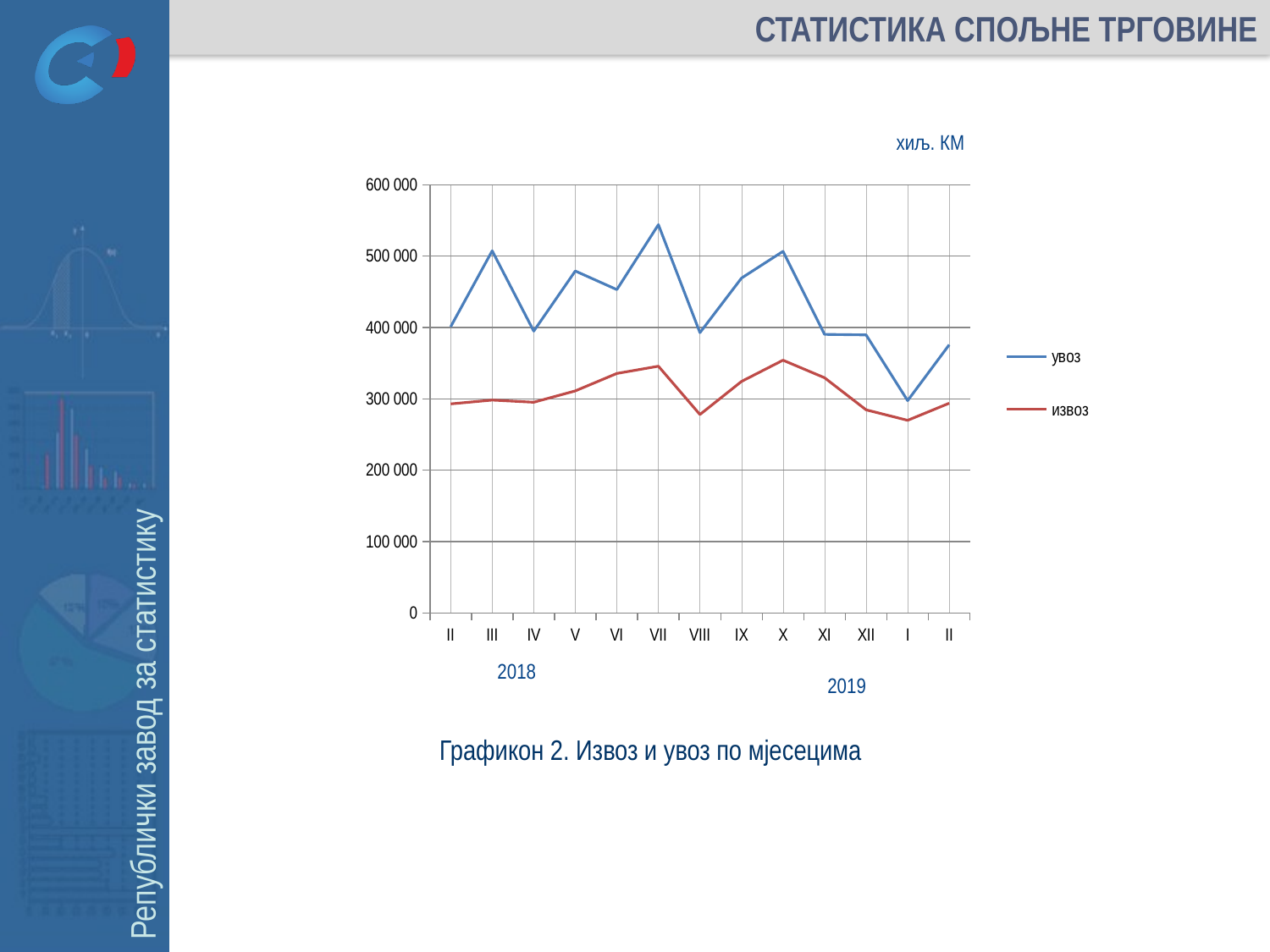
In which month is the value for увоз highest? VII 2018 What kind of chart is shown on the slide? line chart How many months (points) are plotted along the x axis? 13 Is the value for увоз in VII 2018 greater or less than 500 000? greater In which month is the value for увоз lowest? I 2019 Is the value for извоз in X 2018 greater or less than 300 000? greater Which is larger in VII 2018, увоз or извоз? увоз How many series does the legend list? 2 Is the value for увоз in I 2019 greater or less than 400 000? less Does the увоз line rise or fall from X 2018 to I 2019? fall What unit label is shown above the chart? хиљ. KM